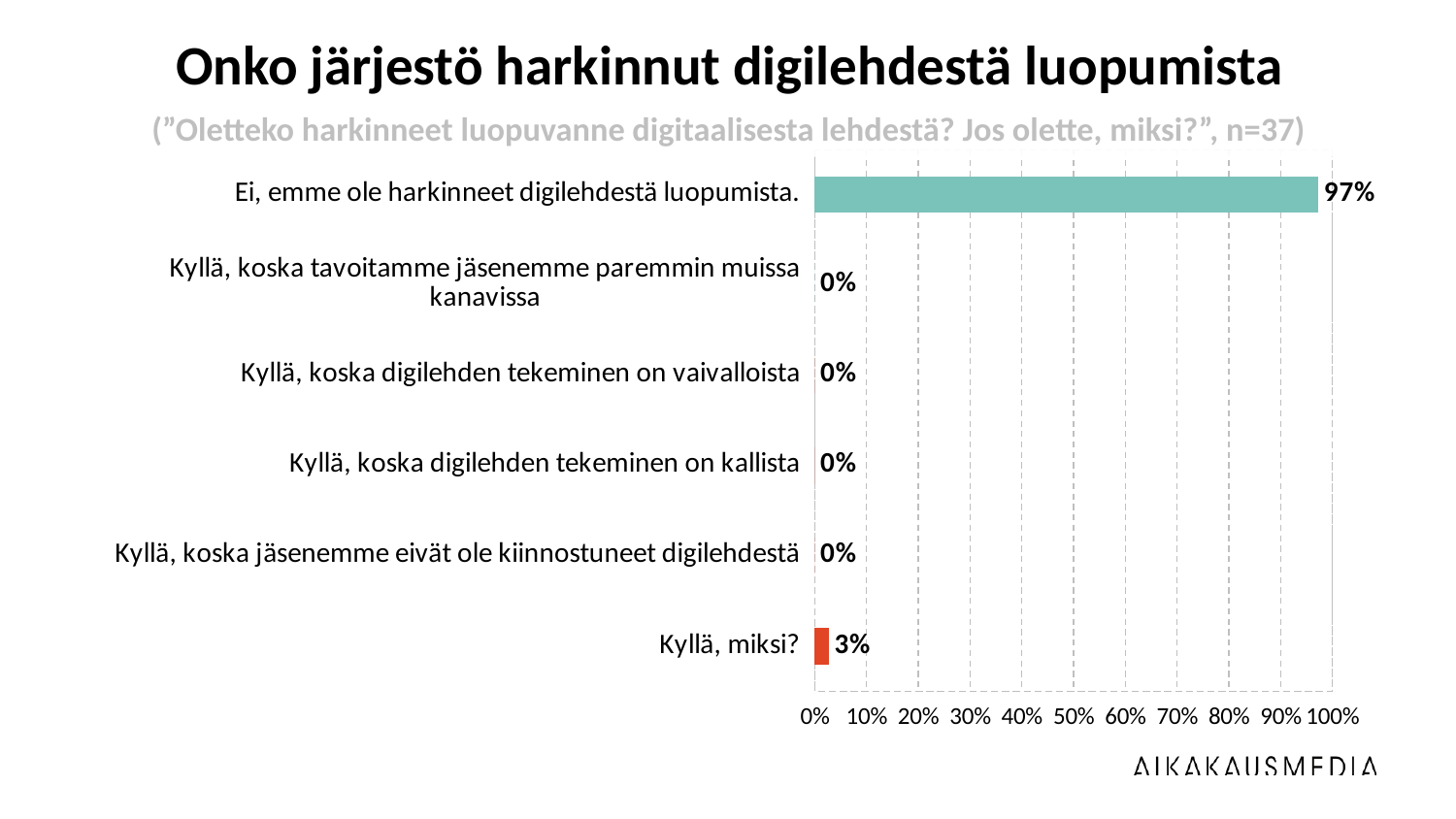
What is the sample size (n) stated in the chart subtitle? n=37 What is the value for "Ei, emme ole harkinneet digilehdestä luopumista."? 97% Which is larger: the value for "Kyllä, miksi?" or the value for "Kyllä, koska digilehden tekeminen on vaivalloista"? Kyllä, miksi? How many categories are shown in the chart? 6 What is the difference between the values for "Ei, emme ole harkinneet digilehdestä luopumista." and "Kyllä, miksi?"? 94% Is the value for "Ei, emme ole harkinneet digilehdestä luopumista." greater or less than 90%? greater What is the value for "Kyllä, miksi?"? 3% How many categories have a value of 0%? 4 What kind of chart is shown on the slide? Bar chart Which category has the highest value? Ei, emme ole harkinneet digilehdestä luopumista. What is the title of the chart? Onko järjestö harkinnut digilehdestä luopumista What is the value for "Kyllä, koska digilehden tekeminen on kallista"? 0%